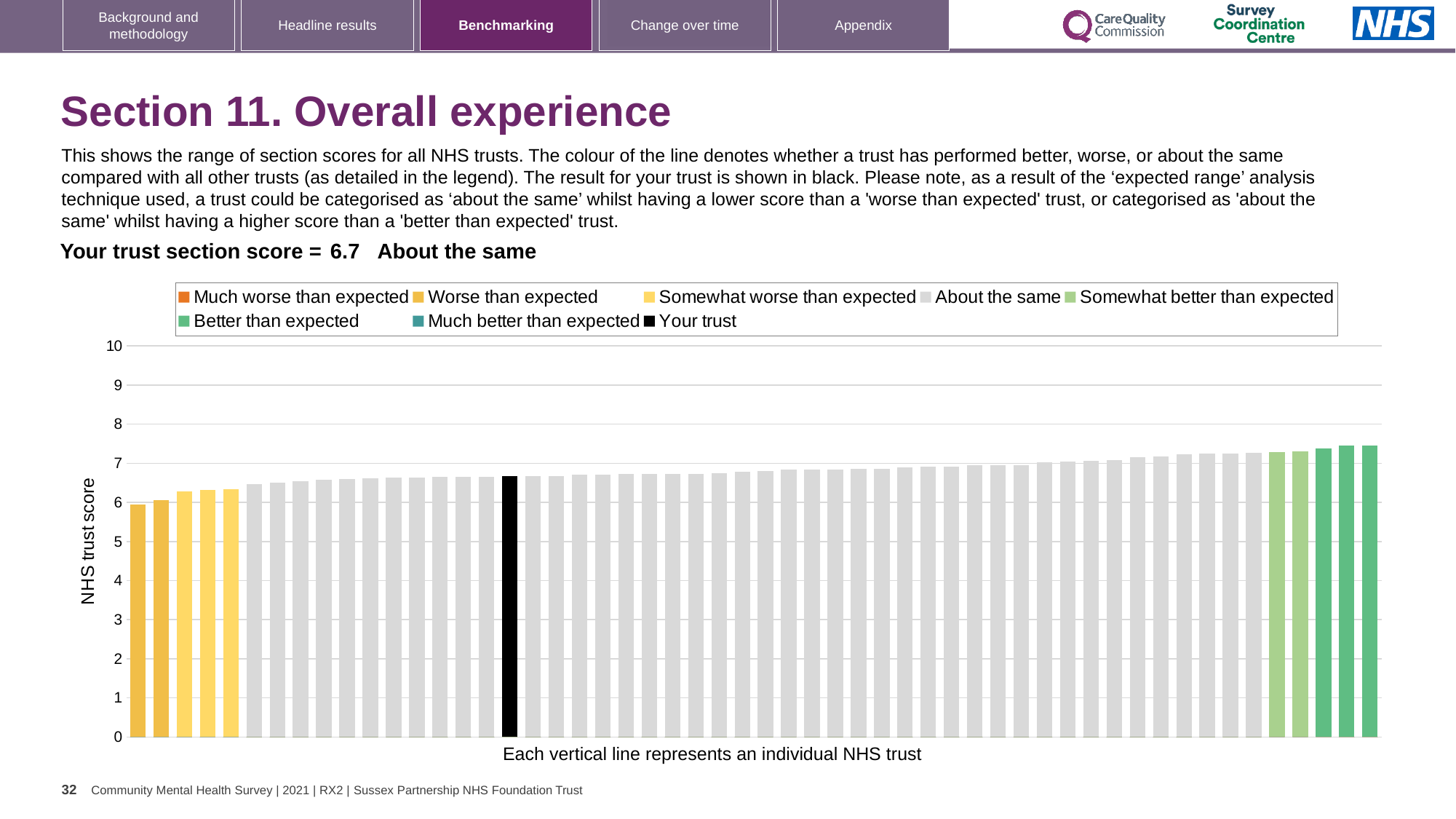
Which legend category do the tallest bars on the right of the chart belong to? Better than expected How many entries does the chart legend list? 8 Is the value for your trust (the black bar) greater or less than 5? greater Is the value for the highest bar in the chart greater or less than 8? less What colour is the bar representing your trust? black Is the value for the lowest bar in the chart greater or less than 5? greater What type of chart is shown on the slide? bar chart Which category is your trust placed in for this section? About the same Do the bar values rise or fall from left to right along the x axis? rise What is the label on the vertical axis of the chart? NHS trust score What is the section score for your trust shown on the slide? 6.7